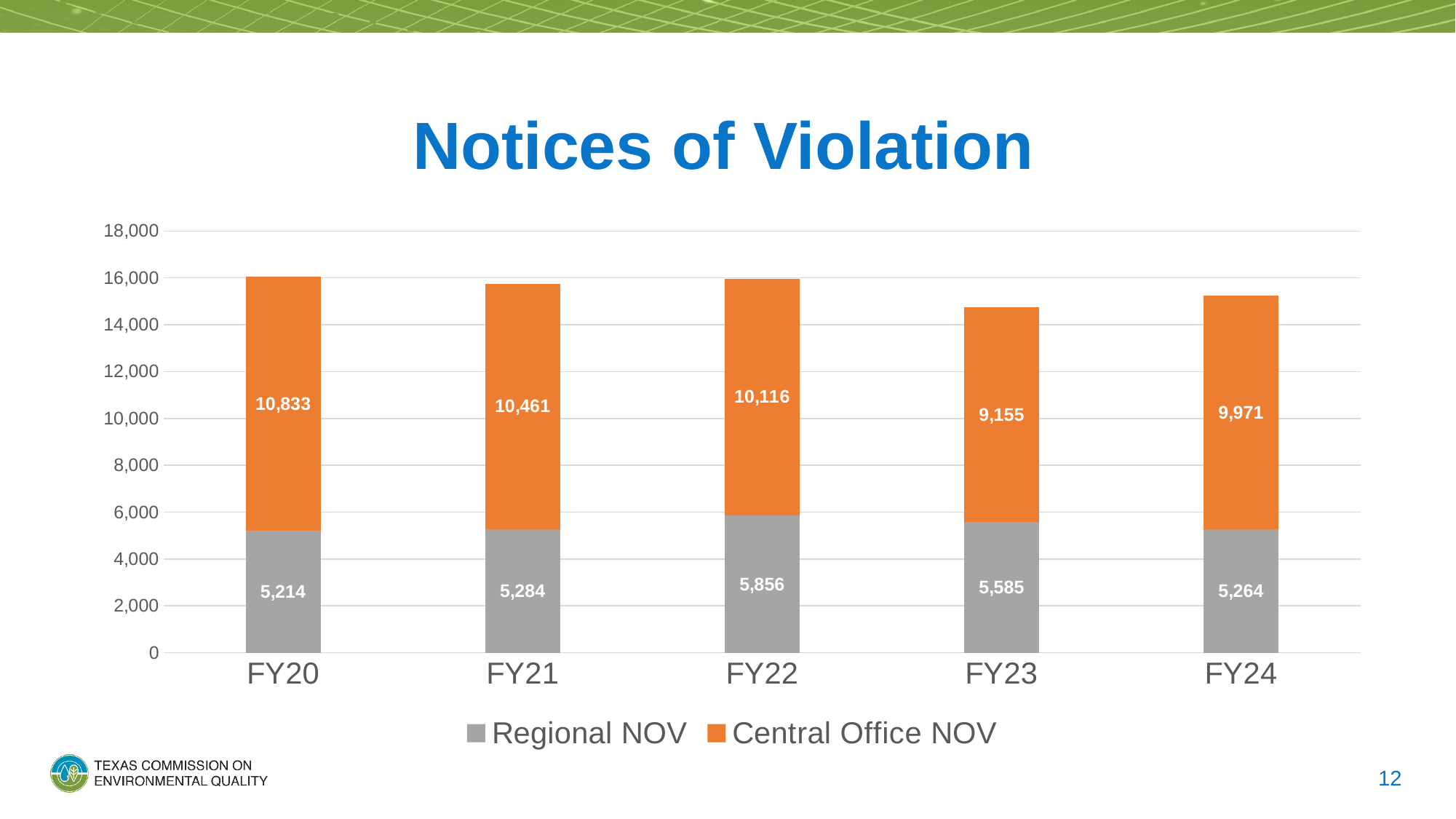
What is the Central Office NOV value for FY23? 9,155 What kind of chart is shown on the slide? Stacked bar chart What is the difference between the Central Office NOV values for FY20 and FY24? 862 What is the Regional NOV value for FY22? 5,856 Which is larger, the Regional NOV value for FY21 or for FY23? FY23 Which fiscal year has the highest Central Office NOV value? FY20 Which fiscal year has the lowest Regional NOV value? FY20 What is the total of the stacked bar for FY22? 15,972 What is the title of the chart? Notices of Violation What is the Central Office NOV value for FY20? 10,833 How many fiscal years are shown on the x axis? 5 How many series does the legend list? 2